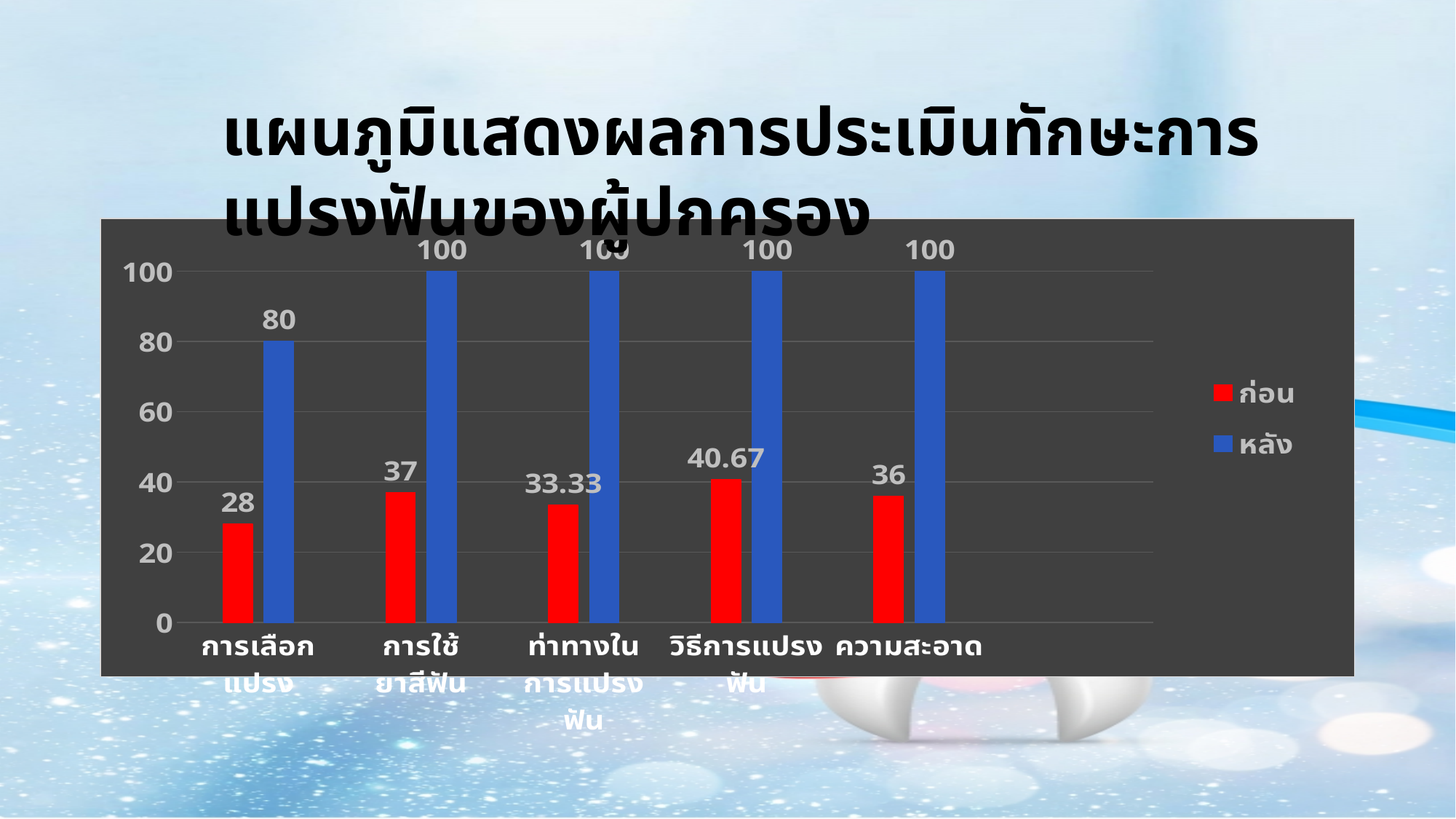
What is the value of the ก่อน series for การเลือกแปรง? 28 What is the value of the ก่อน series for วิธีการแปรงฟัน? 40.67 Which is larger for การใช้ยาสีฟัน, the ก่อน value or the หลัง value? หลัง What is the value of the ก่อน series for ท่าทางในการแปรงฟัน? 33.33 How many series does the legend list? 2 Which category has the highest ก่อน value? วิธีการแปรงฟัน How many categories are shown on the x axis? 5 What is the value of the หลัง series for การเลือกแปรง? 80 What kind of chart is shown on the slide? Bar chart Which category has the lowest หลัง value? การเลือกแปรง What is the difference between the หลัง and ก่อน values for ความสะอาด? 64 Which category has the lowest ก่อน value? การเลือกแปรง